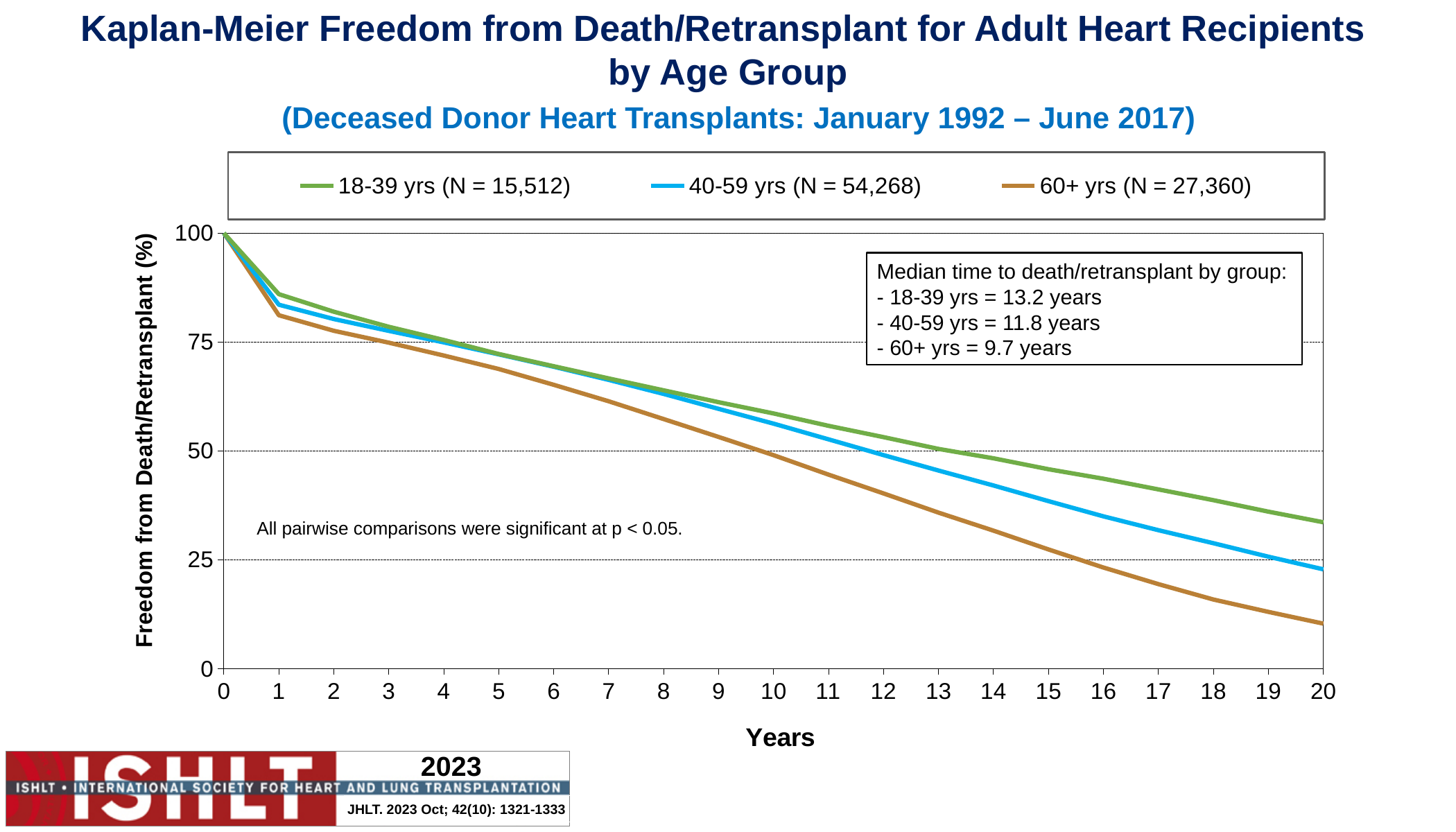
Is the value for the 18-39 yrs group at 20 years greater or less than 25? greater What is the median time to death/retransplant for the 40-59 yrs group? 11.8 years At 20 years, which group has the larger value: 40-59 yrs or 60+ yrs? 40-59 yrs What kind of chart is shown on the slide? line chart How many series does the legend list? 3 Is the value for the 18-39 yrs group at 15 years greater or less than 50? less What is the N for the 60+ yrs group shown in the legend? 27,360 Which age group has the lowest freedom from death/retransplant at 20 years? 60+ yrs Is the value for the 60+ yrs group at 20 years greater or less than 25? less Do the freedom from death/retransplant values rise or fall as years increase? fall Which age group has the highest freedom from death/retransplant at 20 years? 18-39 yrs